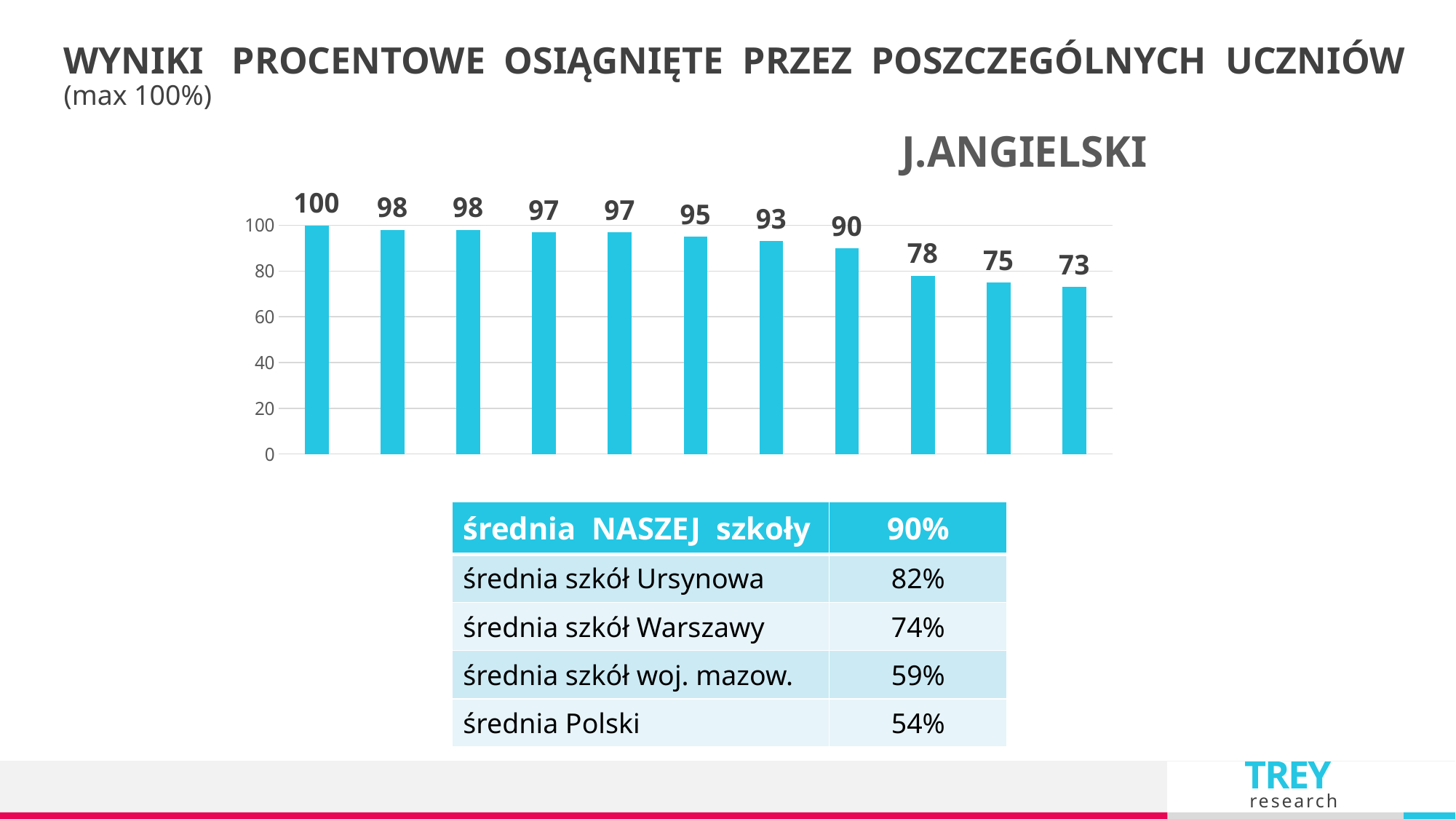
Is the value of the tenth bar from the left greater or less than 80? less How many bars does the chart contain? 11 What is the lowest value shown in the chart? 73 What kind of chart is shown on the slide? bar chart What is the value of the eighth bar from the left in the chart? 90 What is the value of the first (leftmost) bar in the chart? 100 What subject title is shown above the chart? J.ANGIELSKI What is the value of the last (rightmost) bar in the chart? 73 Which is larger: the value of the sixth bar from the left or the value of the ninth bar from the left? the sixth bar (95) What is the difference between the first bar (100) and the last bar (73) in the chart? 27 What is the highest value shown in the chart? 100 Do the values rise or fall from left to right along the x axis? fall